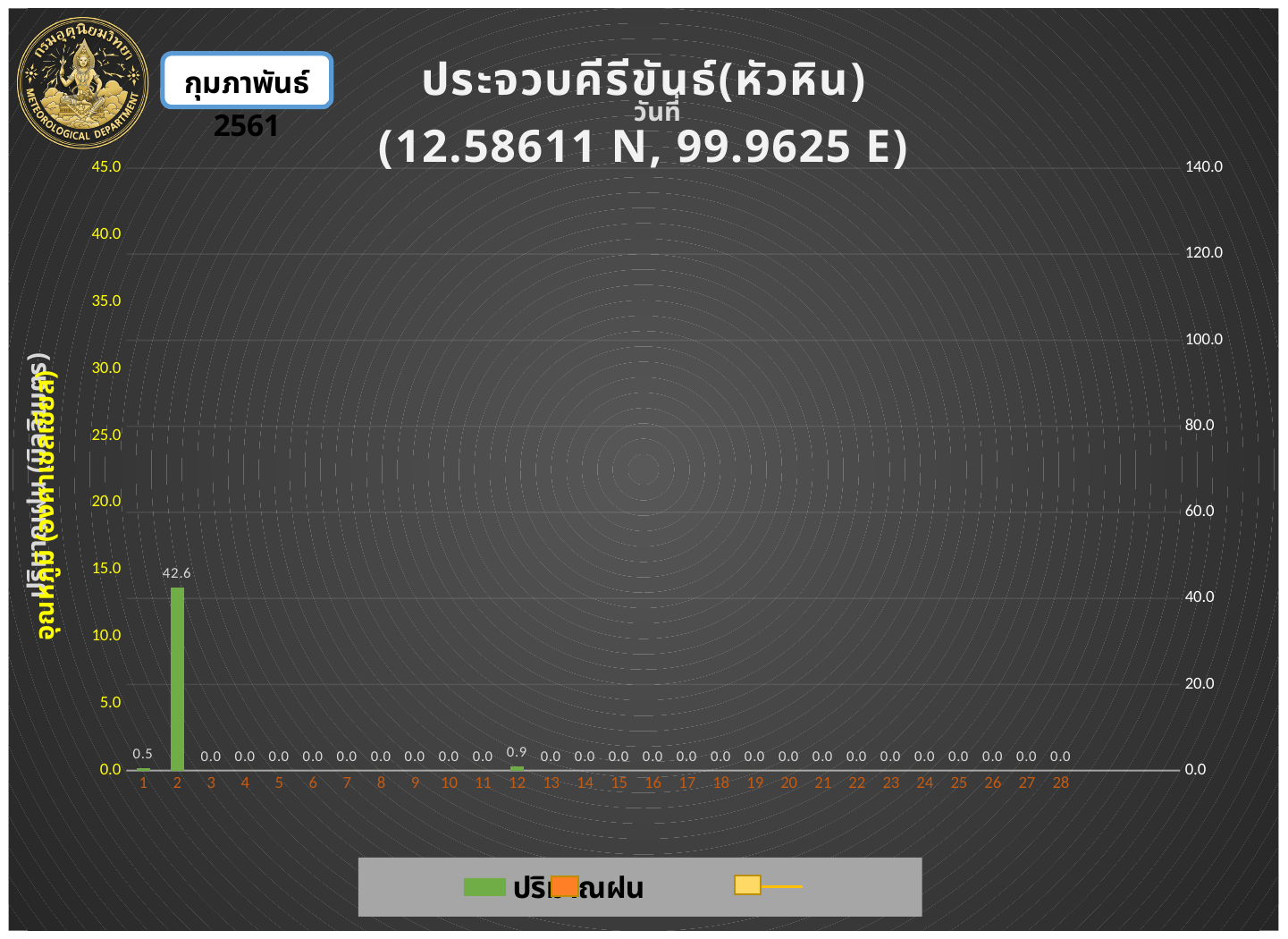
What is the rainfall value shown for day 2? 42.6 Is the rainfall value for day 2 greater or less than 40.0 on the right axis? greater How many days are shown on the x axis? 28 What is the rainfall value shown for day 1? 0.5 What is the difference between the rainfall values for day 2 and day 12? 41.7 What is the highest tick value on the right-hand axis? 140.0 What is the rainfall value shown for day 20? 0.0 What is the difference between the rainfall values for day 12 and day 1? 0.4 What kind of chart is shown on the slide? bar chart Which day has the highest rainfall value? 2 Which has a larger rainfall value, day 1 or day 12? day 12 What is the rainfall value shown for day 12? 0.9